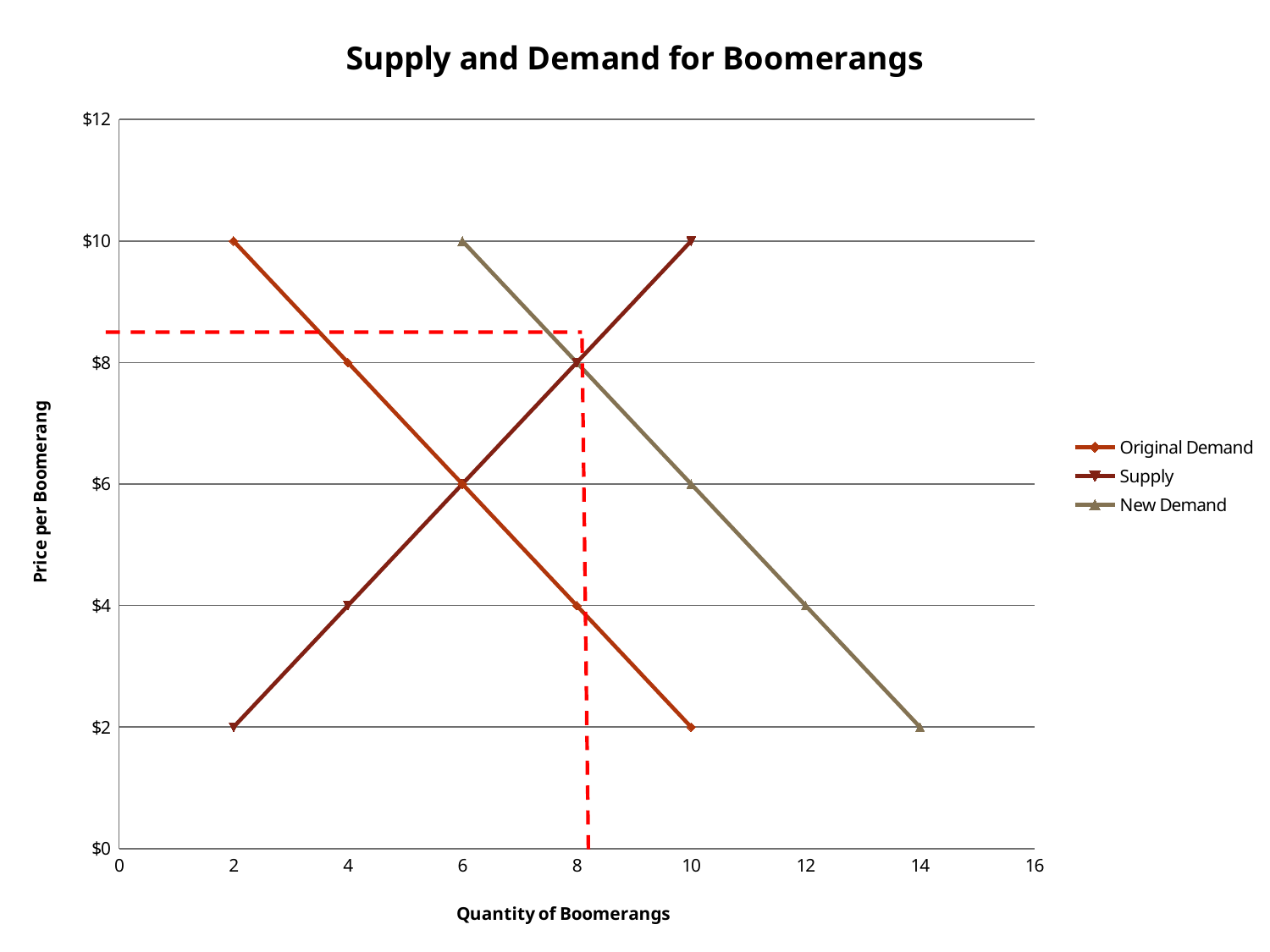
What is the price on the Original Demand line at a quantity of 2 boomerangs? $10 Does the price on the New Demand line rise or fall as quantity increases? fall What kind of chart is shown on the slide? line chart What is the price on the Supply line at a quantity of 4 boomerangs? $4 At what quantity do the Original Demand and Supply lines intersect? 6 What is the difference between the New Demand price and the Original Demand price at a quantity of 8 boomerangs? $4 Does the price on the Supply line rise or fall as quantity increases? rise What is the price on the New Demand line at a quantity of 14 boomerangs? $2 At a quantity of 10 boomerangs, which is higher: the price on the Supply line or the price on the Original Demand line? Supply What is the title of the chart? Supply and Demand for Boomerangs How many series does the legend list? 3 At what price do the New Demand and Supply lines intersect? $8